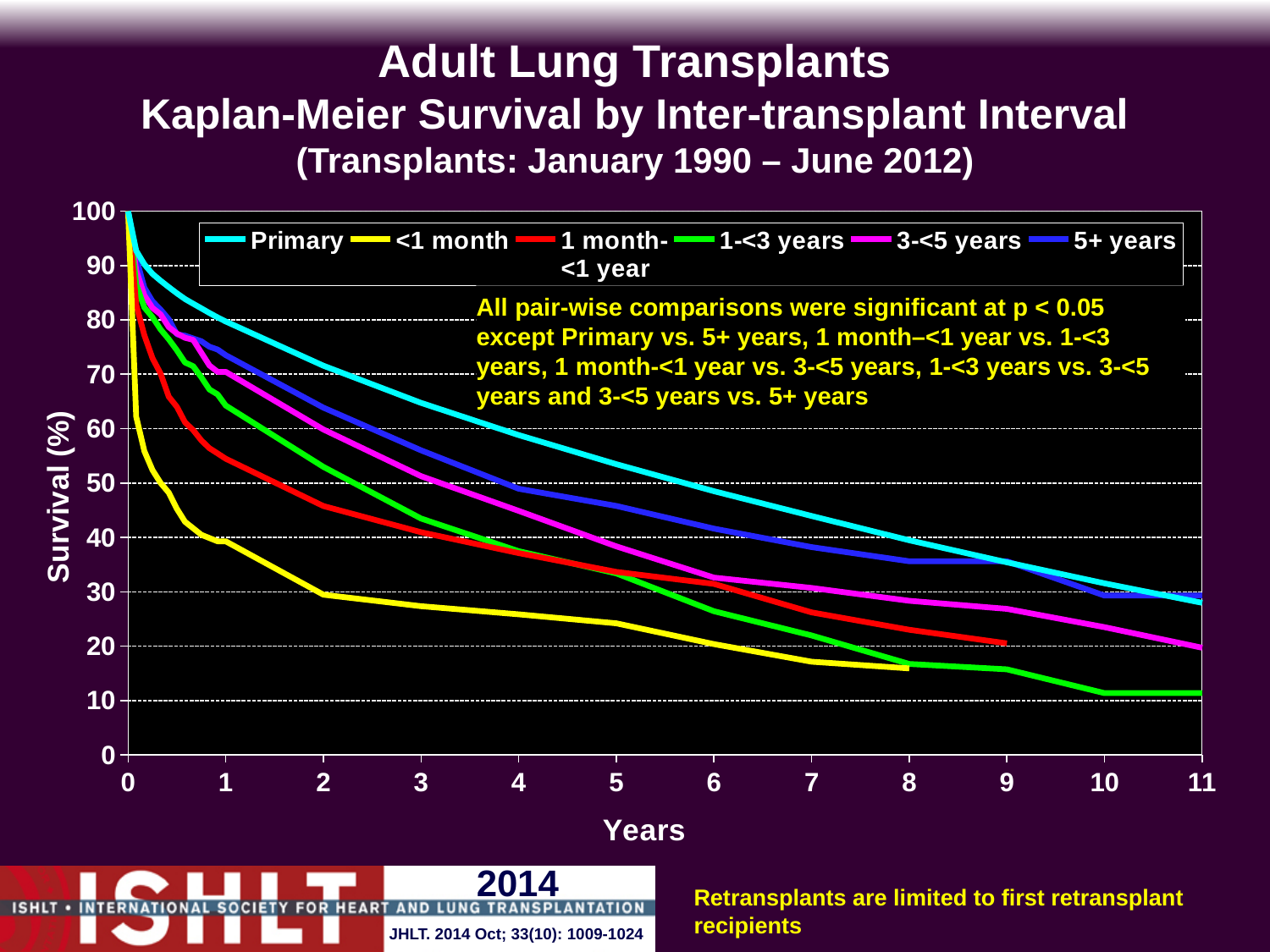
What is the label of the x axis? Years How many series does the legend list? 6 What is the label of the y axis? Survival (%) At year 1, which has higher survival: 5+ years or <1 month? 5+ years Do the survival curves rise or fall as years increase? fall Is the survival for Primary at year 5 greater or less than 50? greater Which series has the highest survival at year 5? Primary What kind of chart is shown on the slide? Line chart Is the survival for 5+ years at year 5 greater or less than 40? greater Is the survival for <1 month at year 5 greater or less than 30? less Which series has the lowest survival at year 5? <1 month